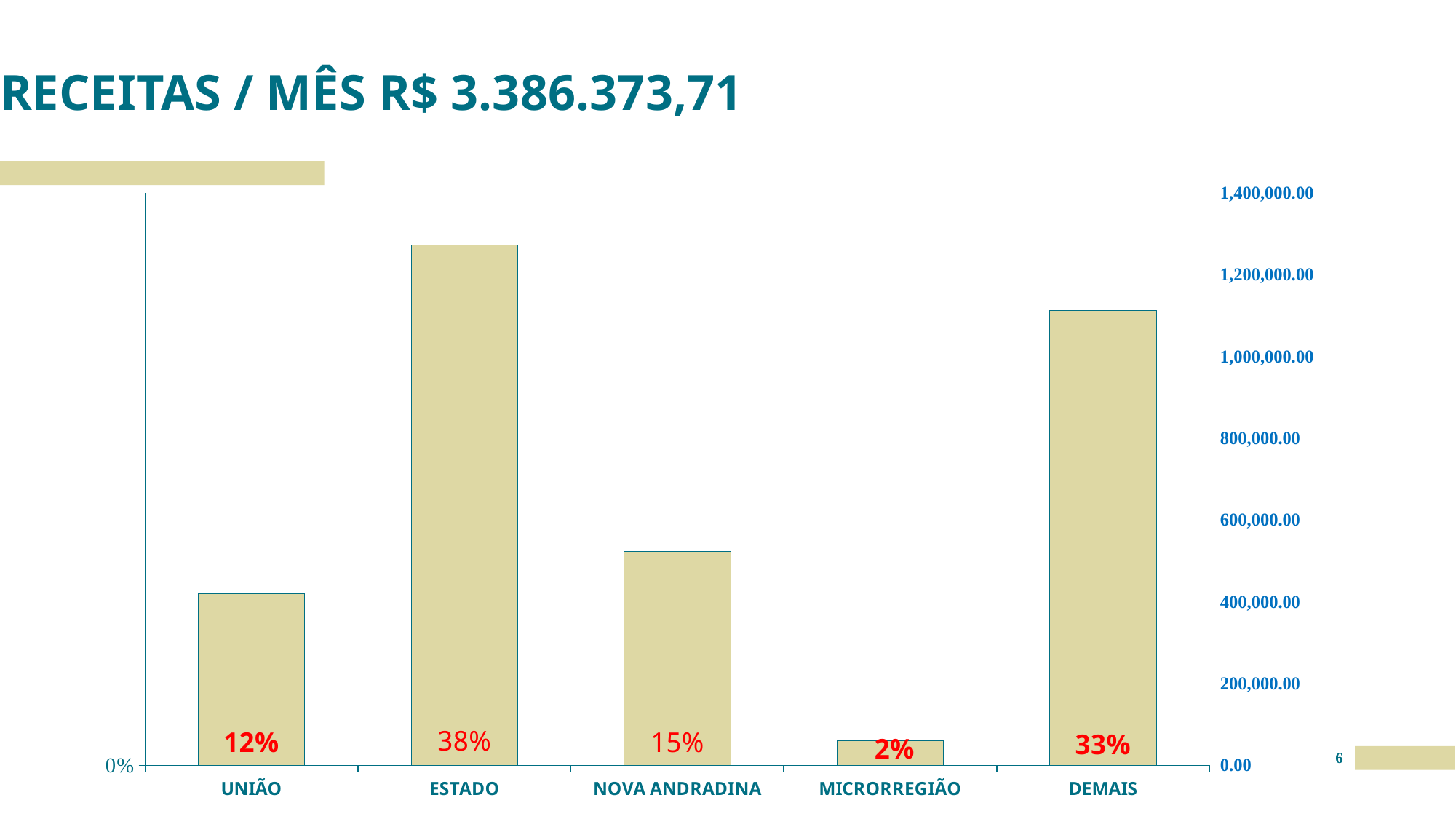
What percentage label is shown on the bar for ESTADO? 38% Is the value for ESTADO greater or less than 1,200,000.00? greater How many categories are shown on the x axis? 5 What percentage label is shown on the bar for UNIÃO? 12% What percentage label is shown on the bar for DEMAIS? 33% Which category has the lowest bar? MICRORREGIÃO Which category has the highest bar? ESTADO What percentage label is shown on the bar for MICRORREGIÃO? 2% What is the difference in percentage points between the ESTADO and DEMAIS labels? 5% What kind of chart is shown on the slide? Bar chart What percentage label is shown on the bar for NOVA ANDRADINA? 15% Which bar is taller, UNIÃO or NOVA ANDRADINA? NOVA ANDRADINA